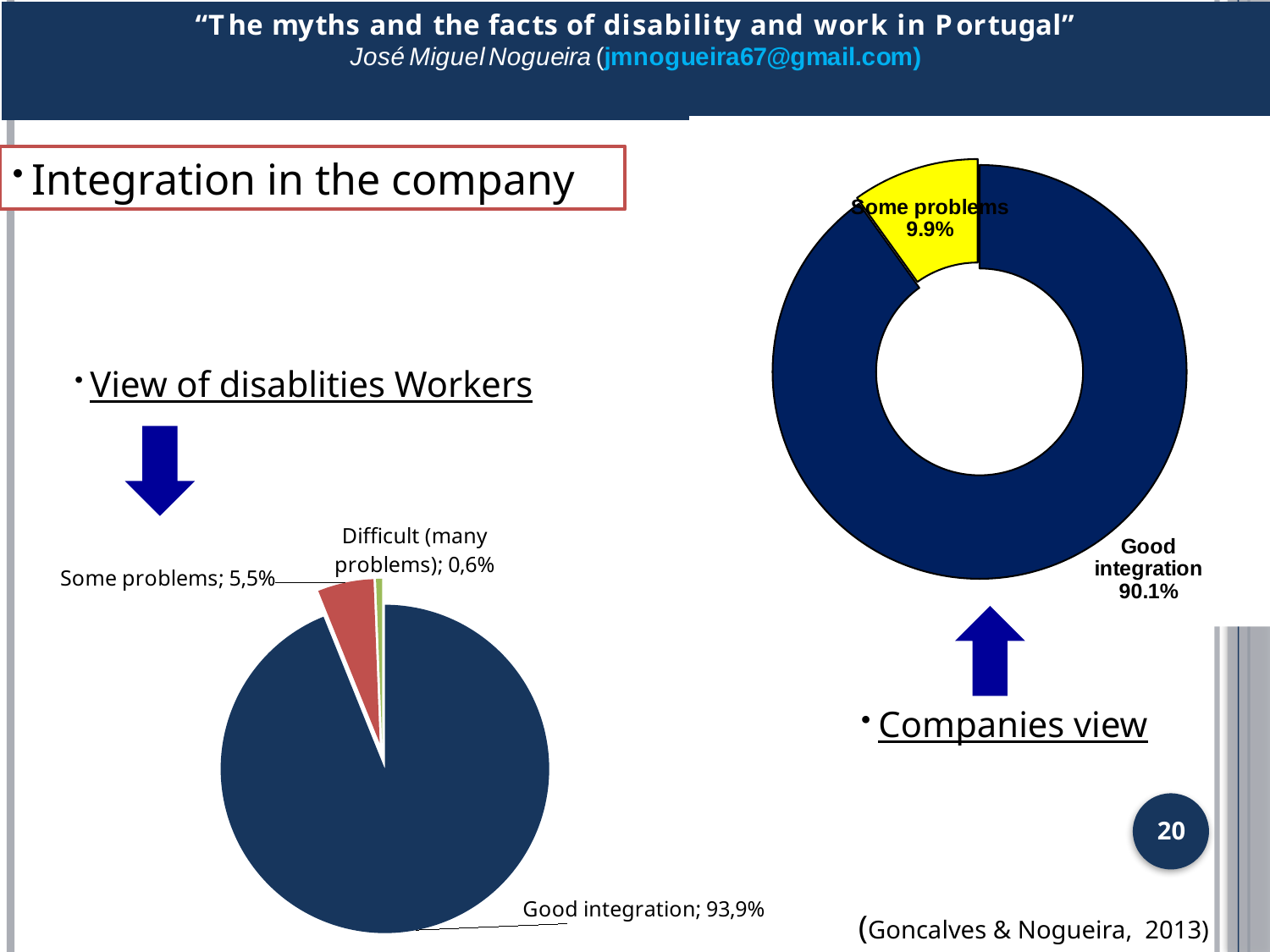
In the doughnut chart on the right (Companies view), what is the value for Some problems? 9.9% In the doughnut chart on the right (Companies view), what is the difference between Good integration and Some problems? 80.2% In the pie chart on the left (View of disabilities Workers), which category has the smallest share? Difficult (many problems) In the doughnut chart on the right (Companies view), how many categories are shown? 2 In the pie chart on the left (View of disabilities Workers), how many categories are shown? 3 In the pie chart on the left (View of disabilities Workers), what is the value for Good integration? 93,9% In the pie chart on the left (View of disabilities Workers), which category has the largest share? Good integration In the doughnut chart on the right (Companies view), what is the value for Good integration? 90.1% In the doughnut chart on the right (Companies view), what colour is the Some problems segment? Yellow In the pie chart on the left (View of disabilities Workers), what is the difference between Some problems and Difficult (many problems)? 4,9% In the pie chart on the left (View of disabilities Workers), what is the value for Some problems? 5,5% In the pie chart on the left (View of disabilities Workers), what is the value for Difficult (many problems)? 0,6%